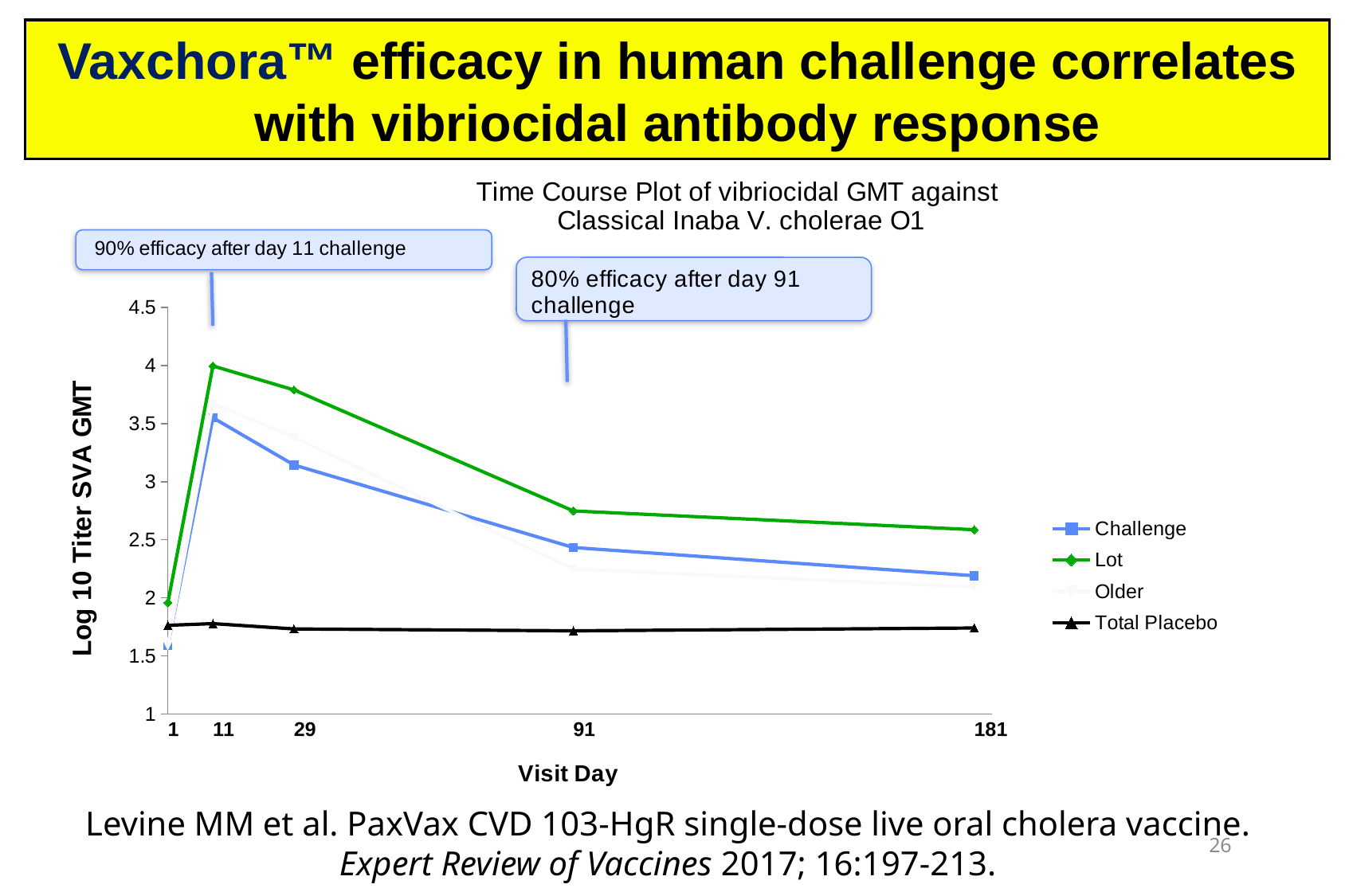
Does the Lot series rise or fall from visit day 11 to visit day 181? fall Which series has the highest value at visit day 91? Lot At visit day 29, which is larger: the Lot value or the Challenge value? Lot What is the title of the x axis? Visit Day What is the title of the y axis? Log 10 Titer SVA GMT Is the Lot value at visit day 11 greater or less than 3.5? greater Which series has the lowest value at visit day 181? Total Placebo What kind of chart is shown on the slide? line chart How many visit days are marked on the x axis? 5 Is the Challenge value at visit day 181 greater or less than 2.5? less How many series does the legend list? 4 Is the Total Placebo value at visit day 91 greater or less than 2? less